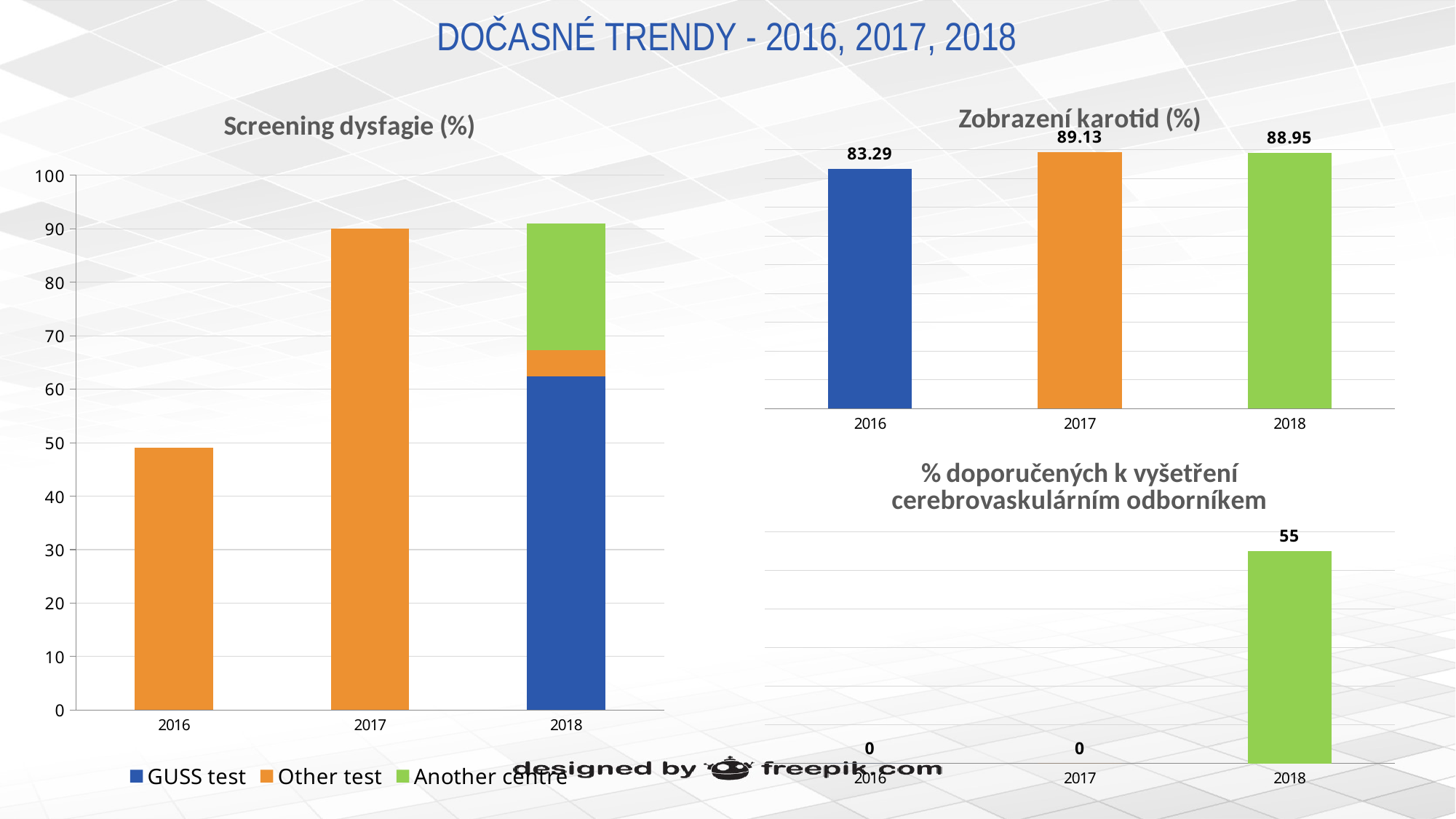
In the 'Zobrazení karotid (%)' chart, which year has the lowest value? 2016 In the 'Screening dysfagie (%)' chart, is the total for 2018 greater or less than 80? greater In the 'Zobrazení karotid (%)' chart, what is the value for 2016? 83.29 In the 'Screening dysfagie (%)' chart, how many series does the legend list? 3 In the 'Screening dysfagie (%)' chart, is the value for 2016 greater or less than 50? less In the '% doporučených k vyšetření cerebrovaskulárním odborníkem' chart, what is the value for 2018? 55 What kind of chart is the 'Screening dysfagie (%)' chart? Stacked bar chart In the '% doporučených k vyšetření cerebrovaskulárním odborníkem' chart, what is the value for 2016? 0 In the 'Zobrazení karotid (%)' chart, what is the difference between the 2017 and 2016 values? 5.84 In the 'Zobrazení karotid (%)' chart, what is the value for 2017? 89.13 In the 'Zobrazení karotid (%)' chart, which year has the highest value? 2017 In the 'Screening dysfagie (%)' chart, which is larger: the total for 2016 or the total for 2017? 2017